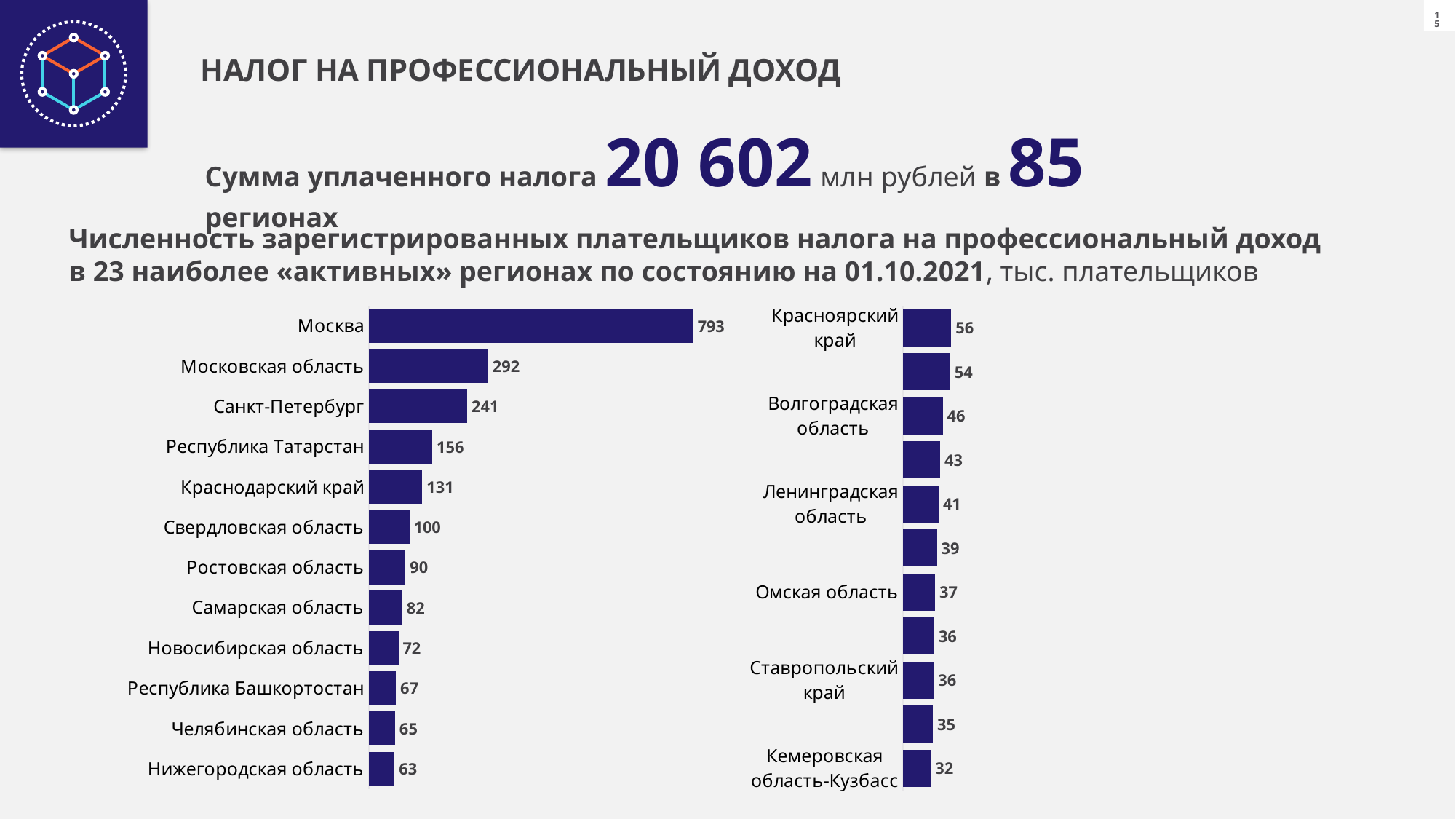
In the left chart, which is larger: the value for Республика Татарстан or the value for Краснодарский край? Республика Татарстан What kind of chart is the left chart? bar chart How many bars are shown in the left chart? 12 In the right chart, what is the value for Волгоградская область? 46 In the right chart, what is the difference between the values for Красноярский край and Омская область? 19 In the left chart, which category has the highest value? Москва In the left chart, what is the value for Санкт-Петербург? 241 In the left chart, which category has the lowest value? Нижегородская область In the left chart, what is the difference between the values for Москва and Московская область? 501 In the left chart, what is the value for Москва? 793 In the left chart, what is the value for Свердловская область? 100 In the right chart, what is the value for Кемеровская область-Кузбасс? 32